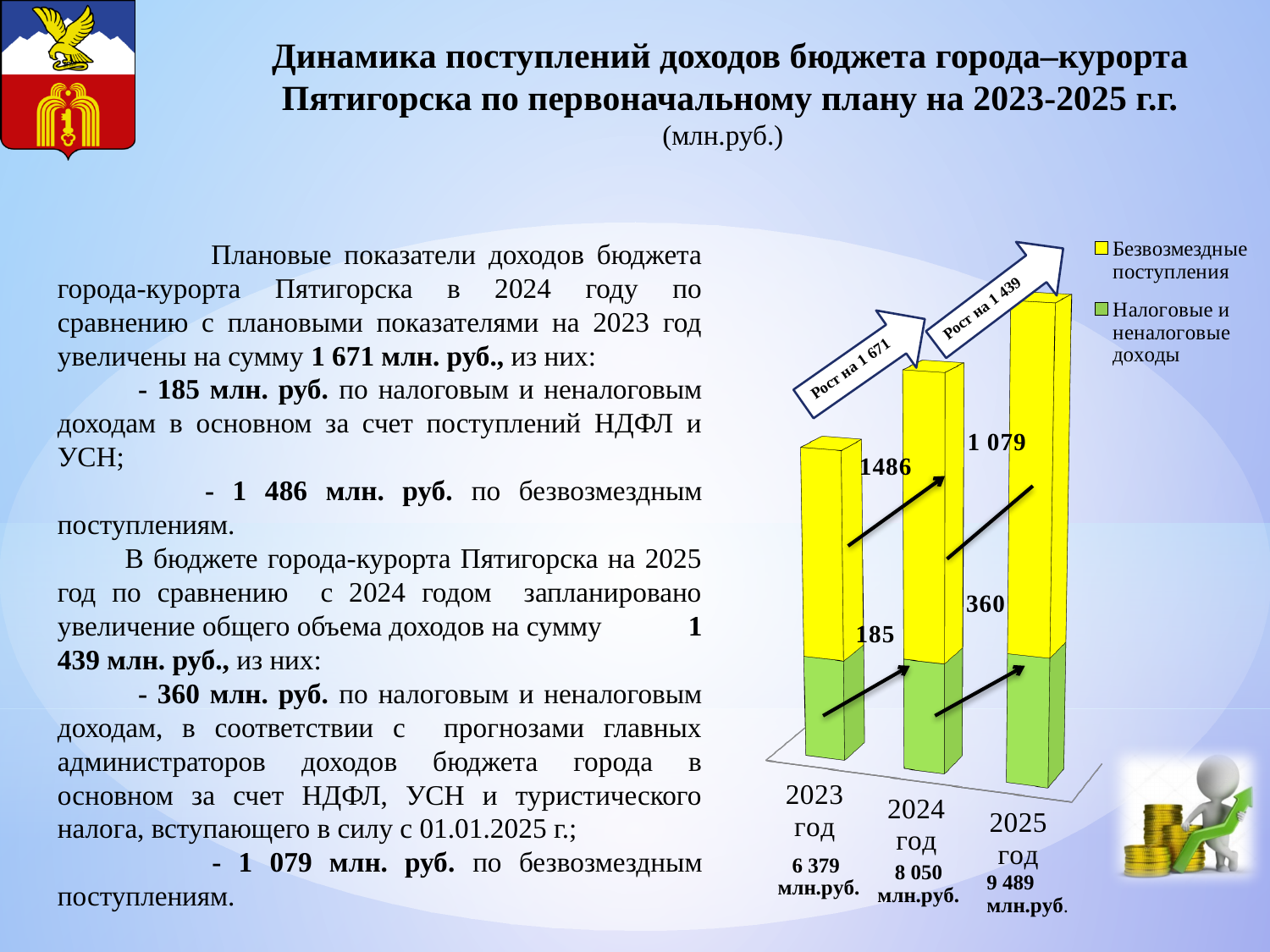
Which series is shown in yellow in the legend? Безвозмездные поступления What is the total budget revenue shown for 2025? 9 489 млн.руб. By how much does the total revenue for 2024 exceed that for 2023? 1 671 How many series does the chart legend list? 2 Which year has the lowest total revenue on the chart? 2023 год What is the total budget revenue shown for 2024? 8 050 млн.руб. Do the total revenues rise or fall from 2023 to 2025? rise How many years (categories) are plotted on the chart? 3 Which year has the highest total revenue on the chart? 2025 год By how much does the total revenue for 2025 exceed that for 2024? 1 439 What is the total budget revenue shown for 2023? 6 379 млн.руб. What kind of chart is shown on the slide? stacked bar chart